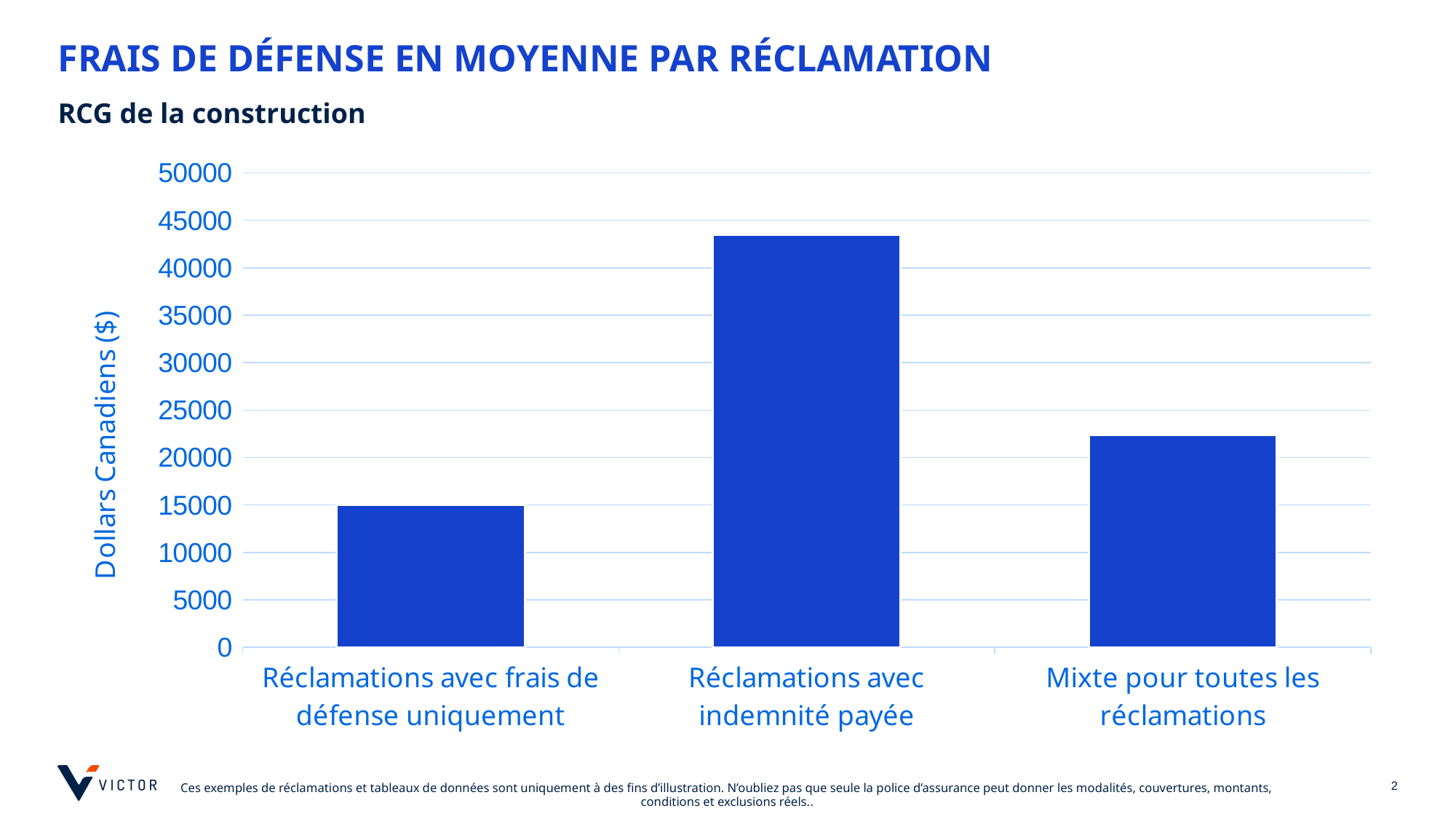
How many categories are plotted in the chart? 3 What is the label of the vertical axis? Dollars Canadiens ($) Which category has the highest average defence cost? Réclamations avec indemnité payée Is the value for 'Mixte pour toutes les réclamations' greater or less than 20000? greater Which is larger: the value for 'Mixte pour toutes les réclamations' or the value for 'Réclamations avec frais de défense uniquement'? Mixte pour toutes les réclamations Is the value for 'Mixte pour toutes les réclamations' greater or less than 25000? less What kind of chart is shown on the slide? bar chart Is the value for 'Réclamations avec frais de défense uniquement' greater or less than 20000? less What is the title of the slide? FRAIS DE DÉFENSE EN MOYENNE PAR RÉCLAMATION Which category has the lowest average defence cost? Réclamations avec frais de défense uniquement